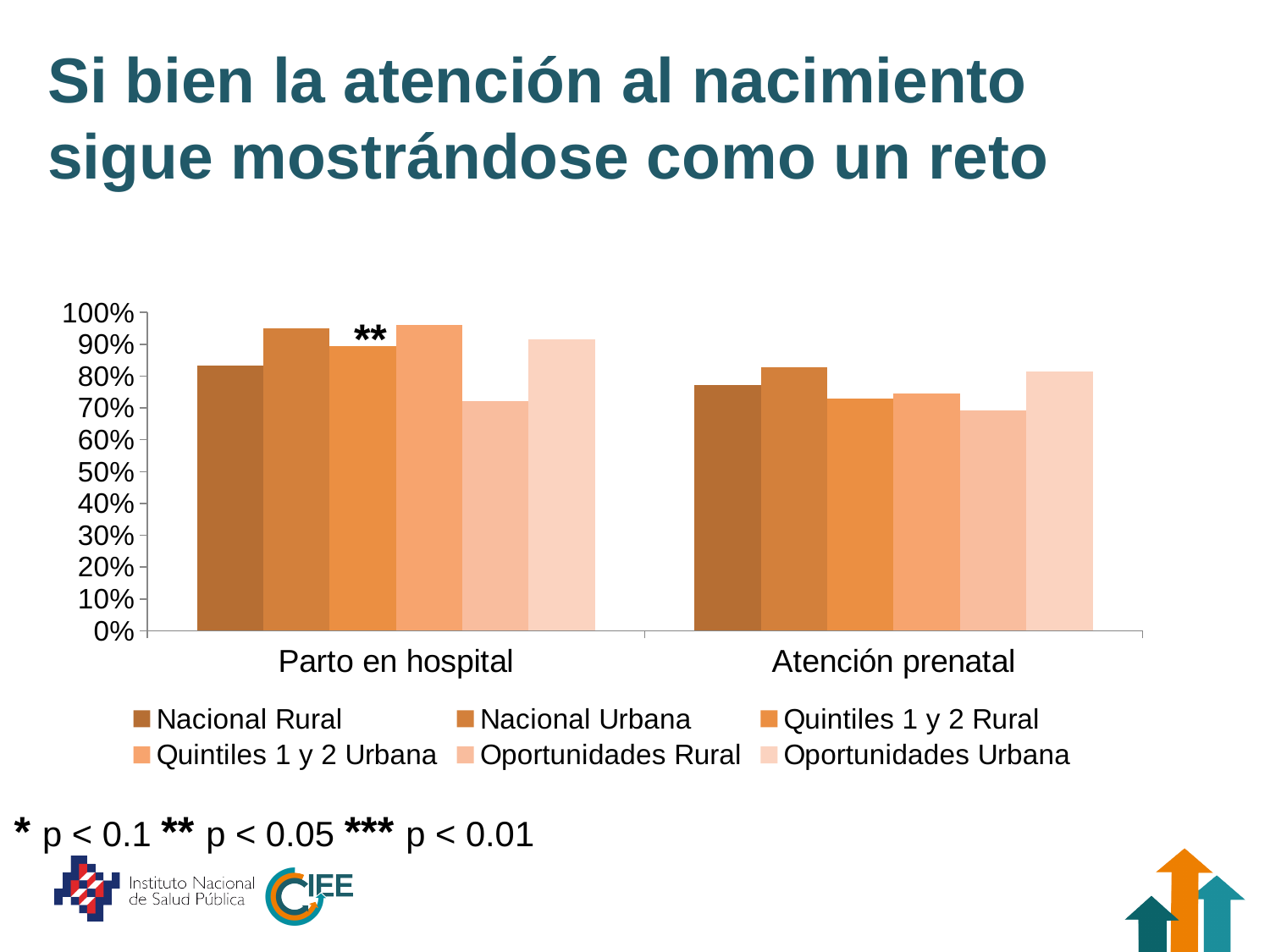
Which series has the lowest value in the Atención prenatal category? Oportunidades Rural What kind of chart is shown on the slide? bar chart Is the value for Oportunidades Rural in the Atención prenatal category greater or less than 60%? greater Which bar in the chart is marked with two asterisks (**)? Quintiles 1 y 2 Rural in Parto en hospital Which is larger in the Atención prenatal category: Nacional Urbana or Quintiles 1 y 2 Rural? Nacional Urbana Which is larger for Nacional Rural: Parto en hospital or Atención prenatal? Parto en hospital How many categories are shown on the x axis of the chart? 2 Is the value for Oportunidades Rural in the Parto en hospital category greater or less than 80%? less Is the value for Nacional Urbana in the Parto en hospital category greater or less than 90%? greater Which series has the lowest value in the Parto en hospital category? Oportunidades Rural How many series does the chart's legend list? 6